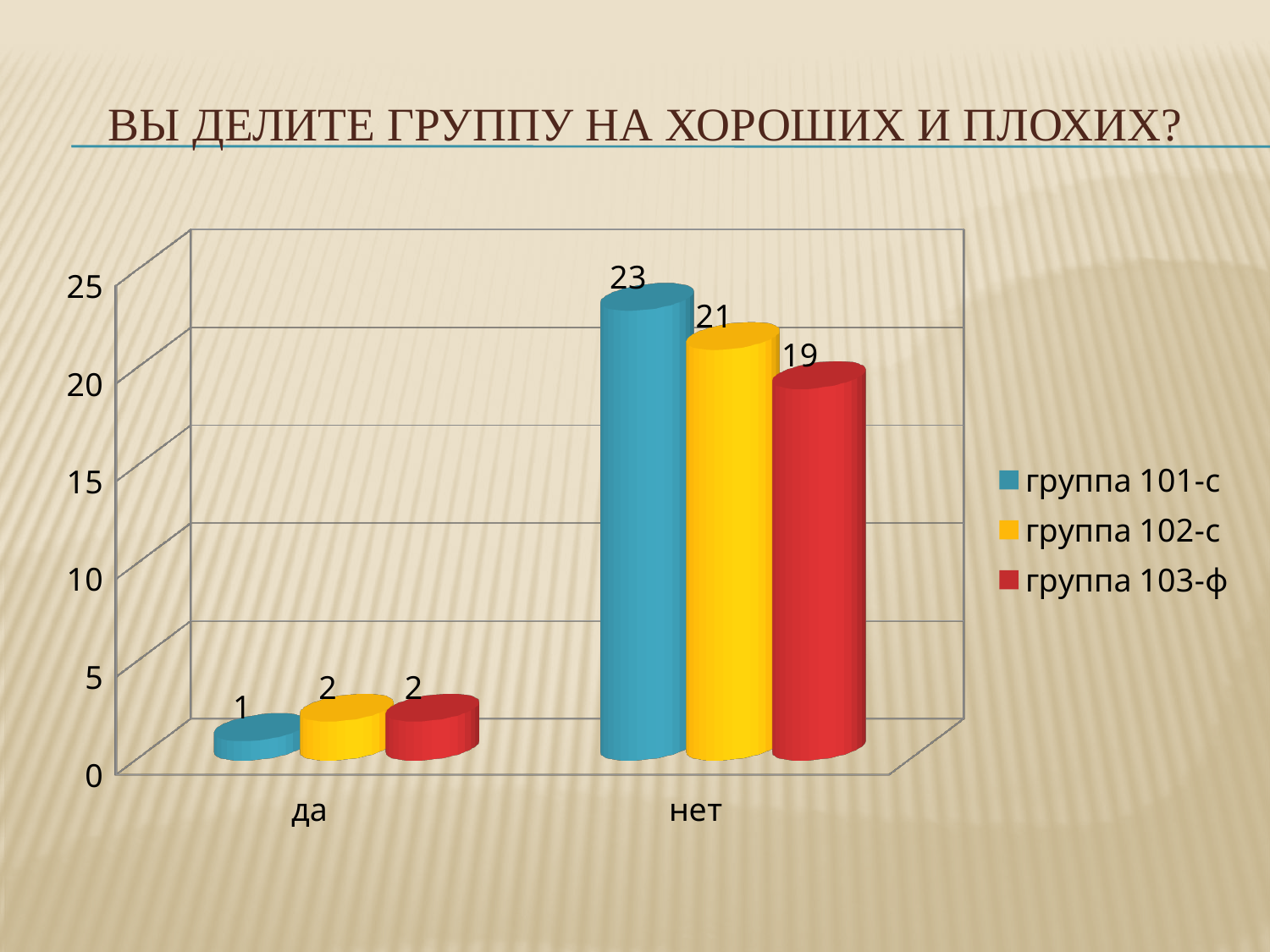
How many categories are shown on the x axis? 2 Which series has the highest value in the нет category? группа 101-с What is the value for группа 101-с in the да category? 1 What is the value for группа 102-с in the да category? 2 Is the value for группа 102-с in the нет category greater or less than 20? greater What is the value for группа 101-с in the нет category? 23 What is the difference between the values for группа 101-с and группа 103-ф in the нет category? 4 What kind of chart is shown on the slide? bar chart Which series has the lowest value in the да category? группа 101-с Which is larger: the value for группа 102-с in нет or the value for группа 103-ф in нет? группа 102-с How many series does the legend list? 3 What is the value for группа 103-ф in the нет category? 19